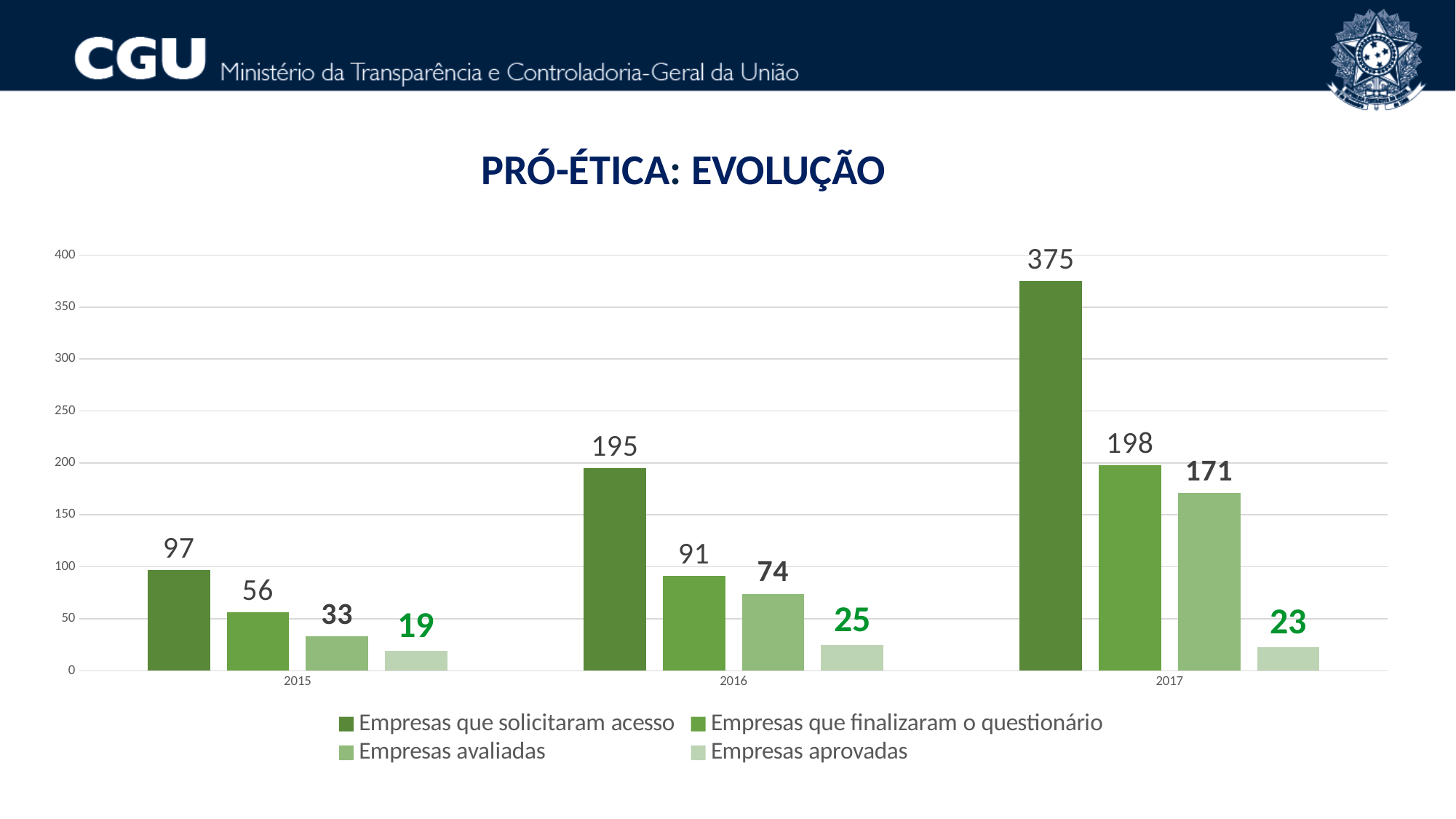
What is the value for 'Empresas que finalizaram o questionário' in 2017? 198 What is the value for 'Empresas avaliadas' in 2016? 74 What kind of chart is shown on the slide? Bar chart Which is larger: 'Empresas avaliadas' in 2017 or 'Empresas que finalizaram o questionário' in 2016? Empresas avaliadas in 2017 What is the value for 'Empresas aprovadas' in 2015? 19 Does 'Empresas avaliadas' rise or fall from 2015 to 2017? Rise What is the difference between 'Empresas que solicitaram acesso' and 'Empresas que finalizaram o questionário' in 2017? 177 How many years are shown on the x axis? 3 How many series does the legend list? 4 What is the value for 'Empresas que solicitaram acesso' in 2017? 375 In which year is 'Empresas que solicitaram acesso' highest? 2017 In which year is 'Empresas aprovadas' lowest? 2015